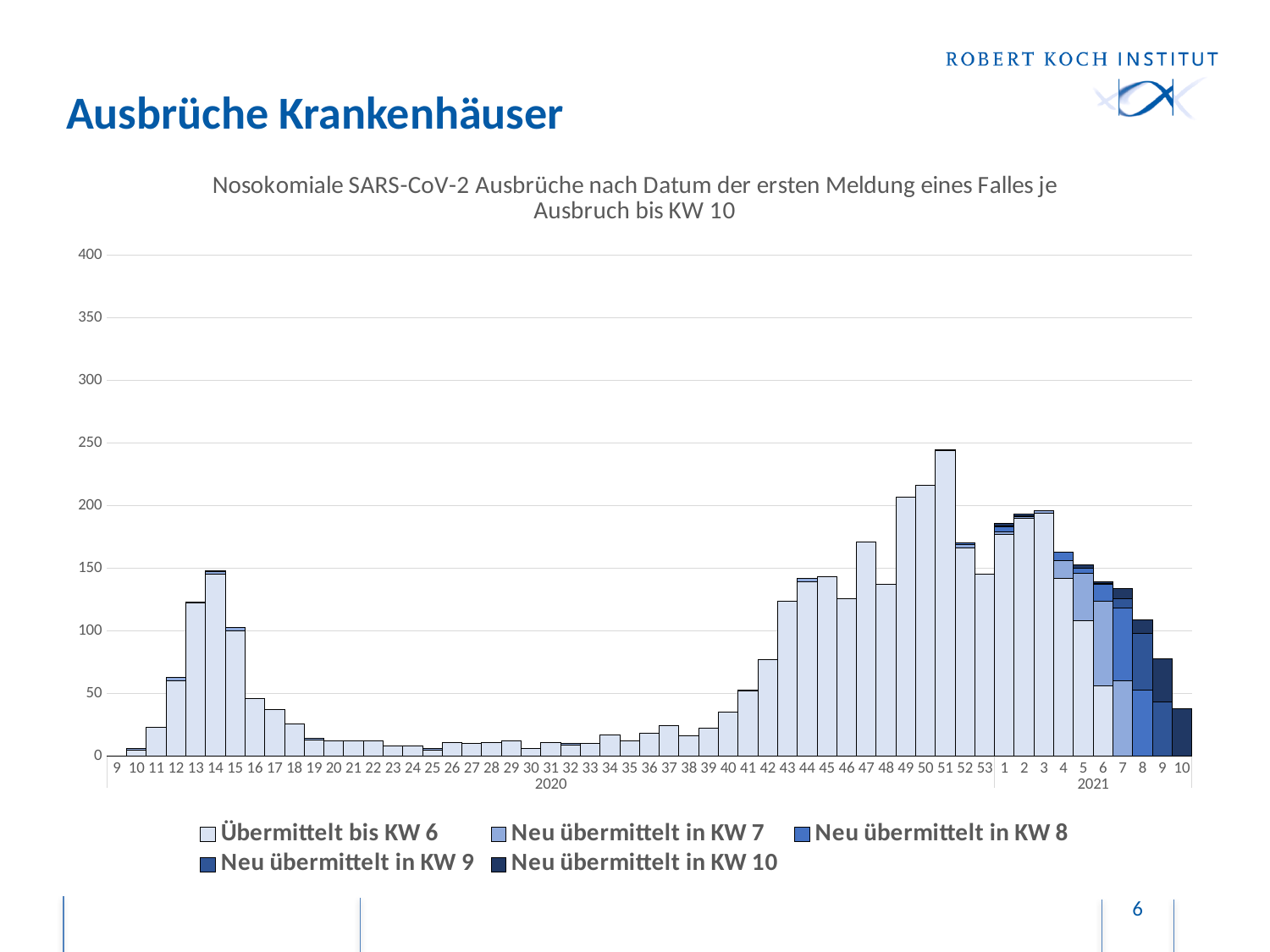
Which is larger, the total for KW 14 2020 or the total for KW 51 2020? KW 51 2020 Is the total for KW 40 2020 greater or less than 50? less Which calendar week has the highest total number of outbreaks? KW 51 2020 How many series does the legend list? 5 What is the title of the chart? Nosokomiale SARS-CoV-2 Ausbrüche nach Datum der ersten Meldung eines Falles je Ausbruch bis KW 10 Is the total for KW 14 2020 greater or less than 100? greater What kind of chart is shown on the slide? Stacked bar chart Is the total for KW 47 2020 greater or less than 150? greater Which is larger, the total for KW 15 2020 or the total for KW 46 2020? KW 46 2020 Do the totals rise or fall from KW 41 2020 to KW 51 2020? rise